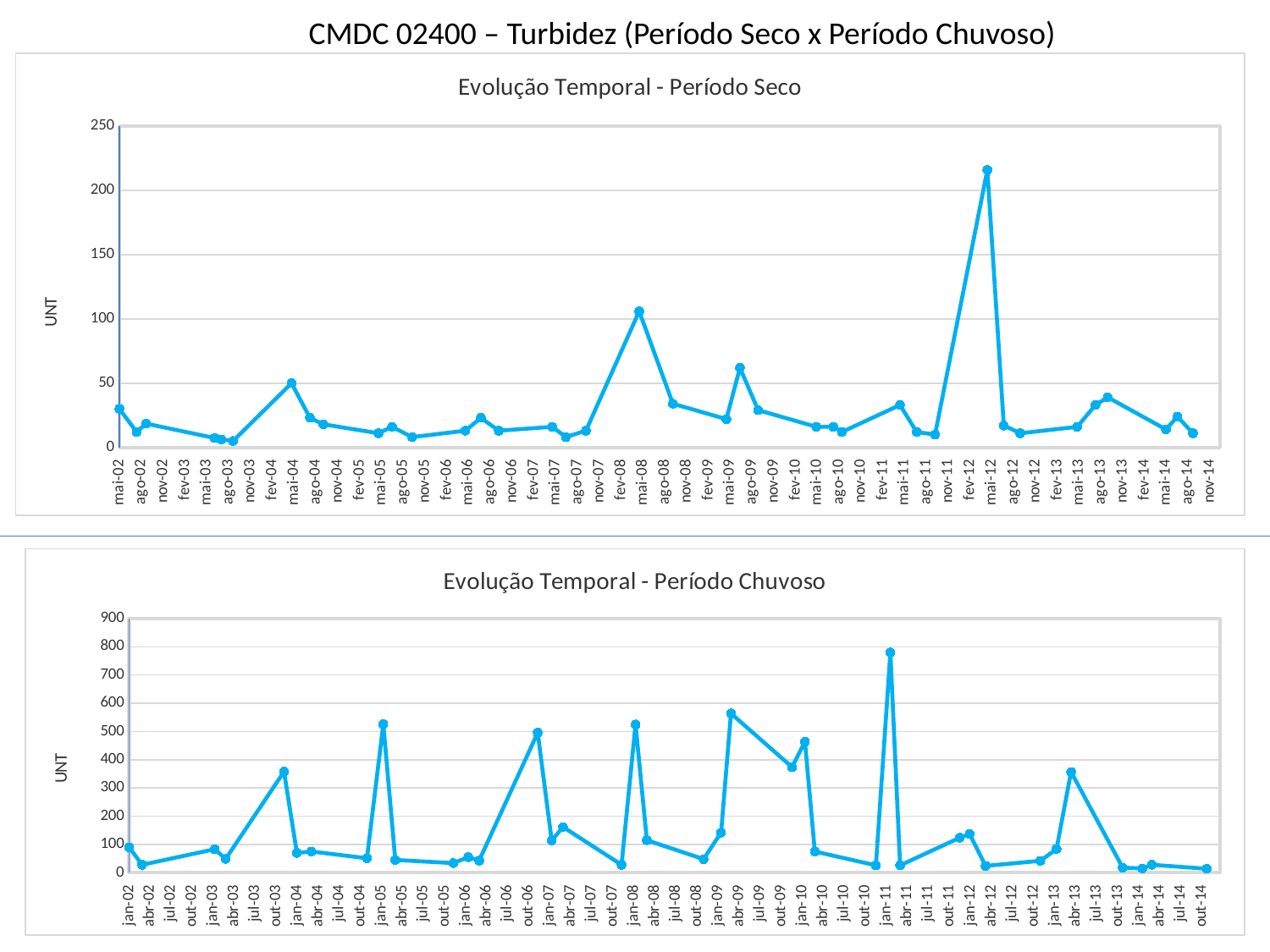
What kind of chart is the bottom chart, 'Evolução Temporal - Período Chuvoso'? line chart In the bottom chart 'Evolução Temporal - Período Chuvoso', which is larger, the value for jan-11 or the value for abr-09? jan-11 In the top chart 'Evolução Temporal - Período Seco', which is larger, the value for mai-12 or the value for mai-08? mai-12 In the bottom chart 'Evolução Temporal - Período Chuvoso', at which date does the line reach its highest value? jan-11 What is the label on the vertical axis of the top chart 'Evolução Temporal - Período Seco'? UNT In the top chart 'Evolução Temporal - Período Seco', is the value for mai-08 greater or less than 50? greater In the top chart 'Evolução Temporal - Período Seco', is the value for mai-12 greater or less than 200? greater What kind of chart is the top chart, 'Evolução Temporal - Período Seco'? line chart In the bottom chart 'Evolução Temporal - Período Chuvoso', is the value for jan-10 greater or less than 500? less In the top chart 'Evolução Temporal - Período Seco', at which date does the line reach its highest value? mai-12